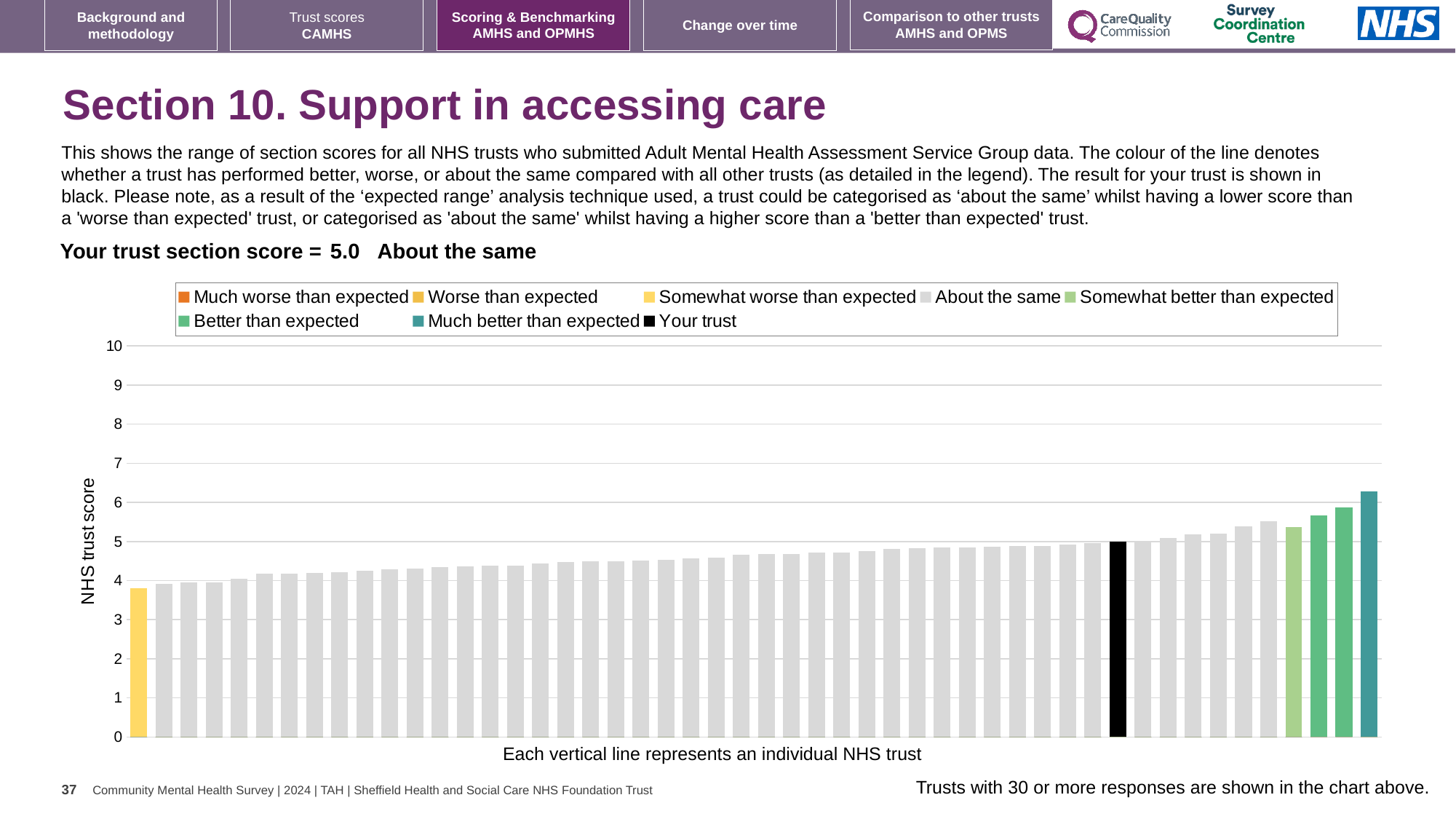
What is the section score for your trust? 5.0 Which legend category does the tallest bar belong to? Much better than expected Is the value of the black 'Your trust' bar greater or less than 4? greater Which category is your trust placed in for this section? About the same Do the bar values rise or fall from left to right along the x axis? Rise What is the label on the vertical axis of the chart? NHS trust score Which legend category does the shortest bar belong to? Somewhat worse than expected Is the value of the leftmost (yellow) bar greater or less than 4? less Is the value of the black 'Your trust' bar greater or less than 6? less What kind of chart is shown on the slide? Bar chart How many entries does the chart legend list? 8